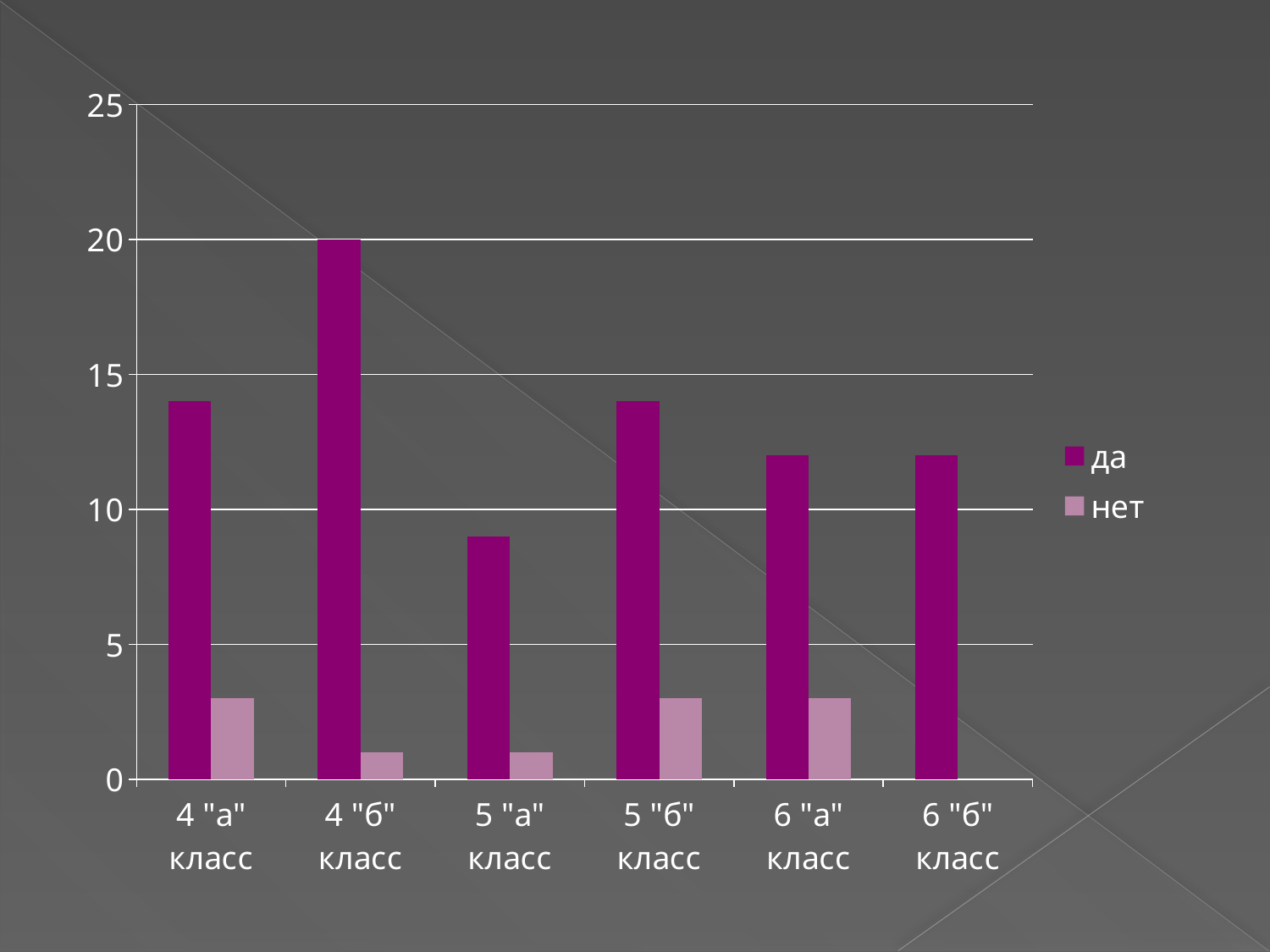
What kind of chart is shown on the slide? bar chart Which class has the lowest value for "да"? 5 "а" класс What are the two legend entries of the chart? да, нет Which class has the highest value for "да"? 4 "б" класс Is the value of "нет" for 4 "а" класс greater or less than 5? less Which is larger for 5 "б" класс: "да" or "нет"? да Is the value of "да" for 4 "а" класс greater or less than 10? greater How many classes (categories) are shown on the x axis? 6 How many series does the legend list? 2 What is the value of "да" for 4 "б" класс? 20 Is the value of "да" for 5 "а" класс greater or less than 10? less Which is larger: the "да" value for 4 "б" класс or the "да" value for 6 "а" класс? 4 "б" класс